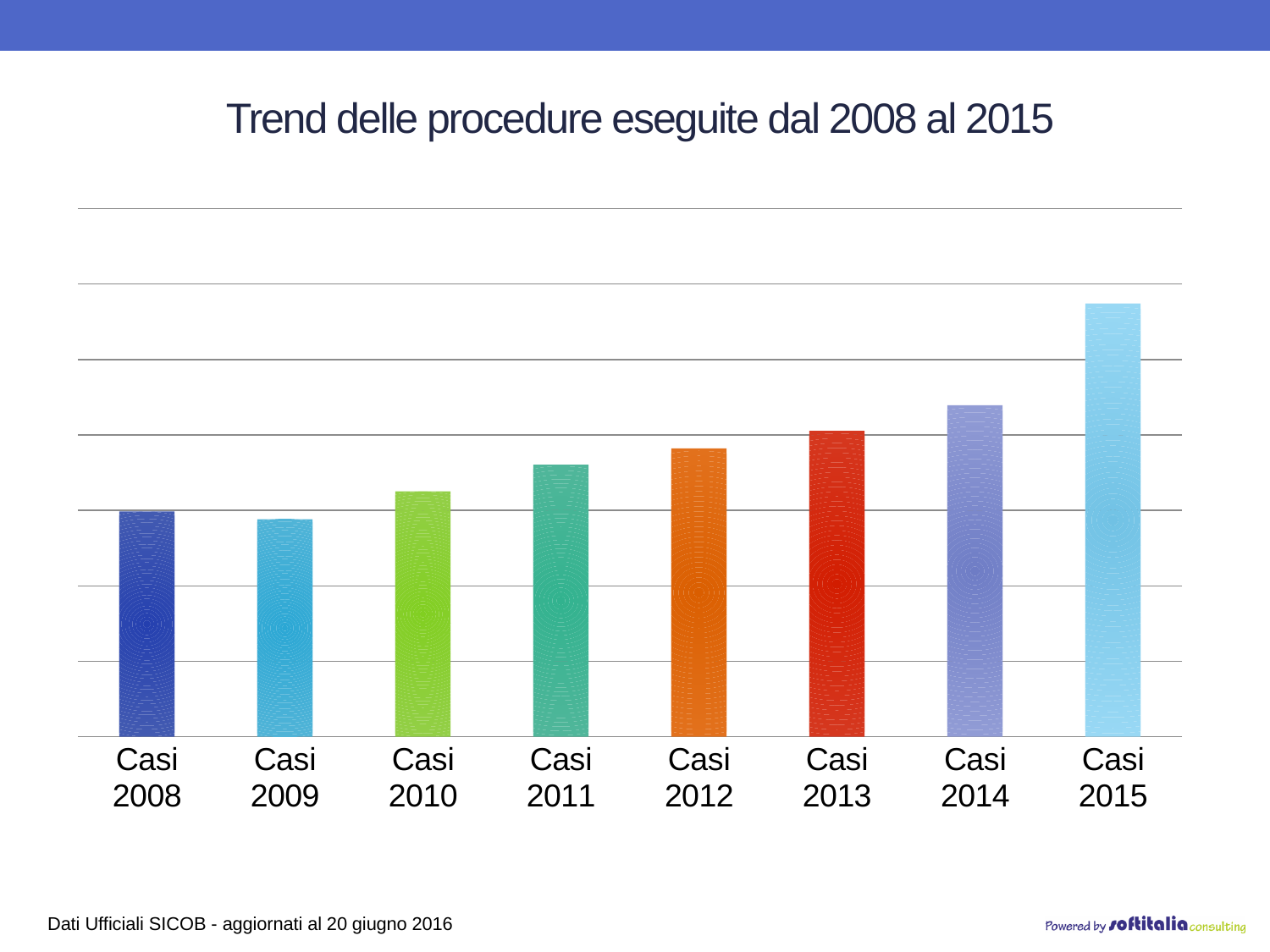
Which is larger, the value for Casi 2014 or the value for Casi 2015? Casi 2015 How many categories (bars) does the chart show? 8 What is the title of the chart? Trend delle procedure eseguite dal 2008 al 2015 Which category has the lowest bar? Casi 2009 Which is larger, the value for Casi 2011 or the value for Casi 2013? Casi 2013 Do the values generally rise or fall from Casi 2009 to Casi 2015? rise Which category has the highest bar? Casi 2015 What data source is cited at the bottom of the slide? Dati Ufficiali SICOB - aggiornati al 20 giugno 2016 What kind of chart is shown on the slide? bar chart Which is larger, the value for Casi 2012 or the value for Casi 2010? Casi 2012